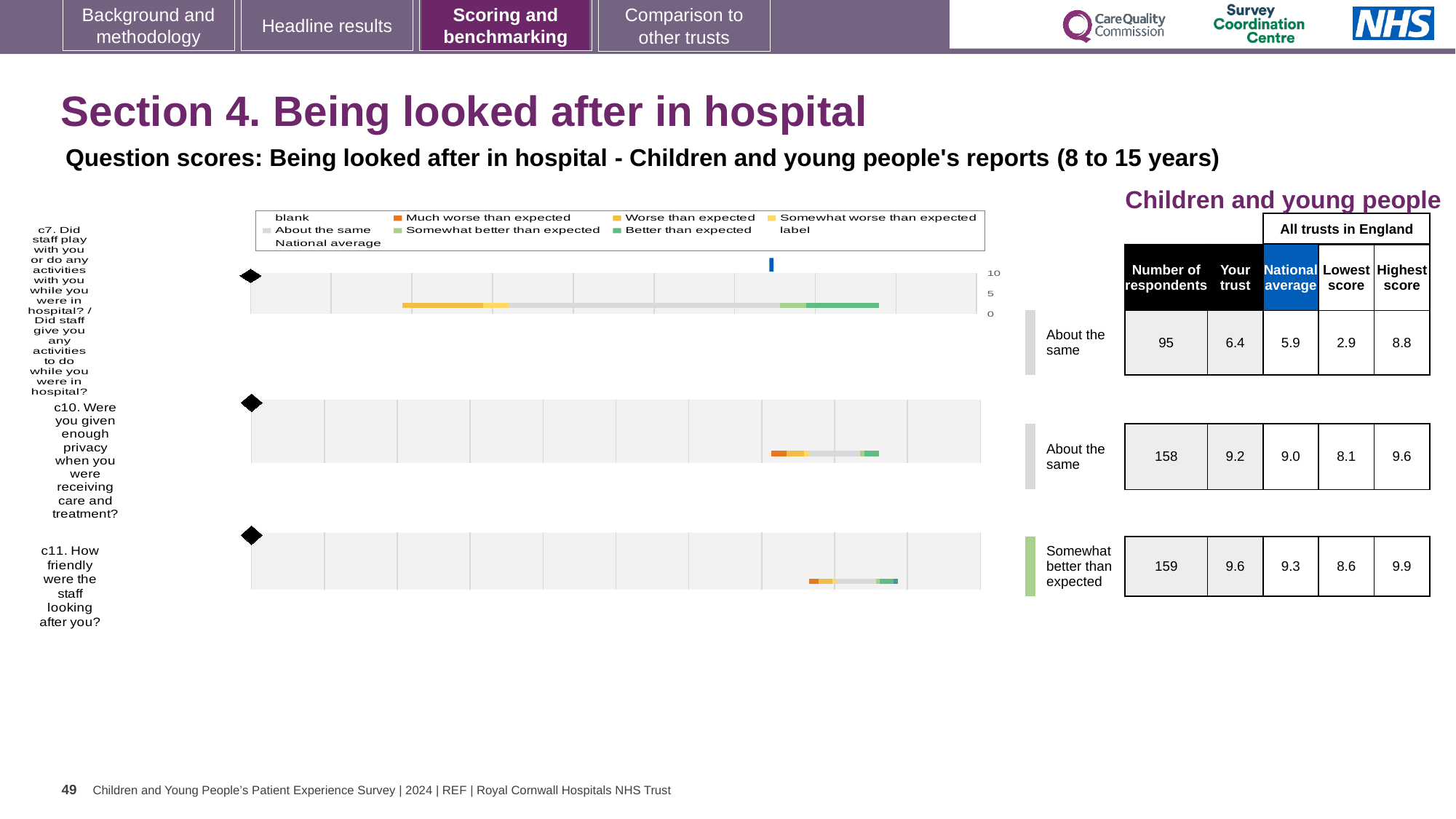
How many respondents answered question c11 (How friendly were the staff looking after you?)? 159 What is the 'Your trust' score for question c10 (Were you given enough privacy when you were receiving care and treatment?)? 9.2 For question c10, which is larger: the 'Your trust' score or the national average? Your trust What benchmark category is shown for question c11? Somewhat better than expected How many questions are plotted in the chart? 3 Is the 'Your trust' score for question c7 greater or less than 5? greater What kind of chart is used to show the question scores on this slide? bar chart What is the highest score among all trusts in England for question c10? 9.6 For question c11, what is the difference between the 'Your trust' score and the national average? 0.3 Which question has the highest 'Your trust' score? c11 Which question has the lowest 'Your trust' score? c7 What is the national average score for question c7 (Did staff play with you or do any activities with you while you were in hospital?)? 5.9